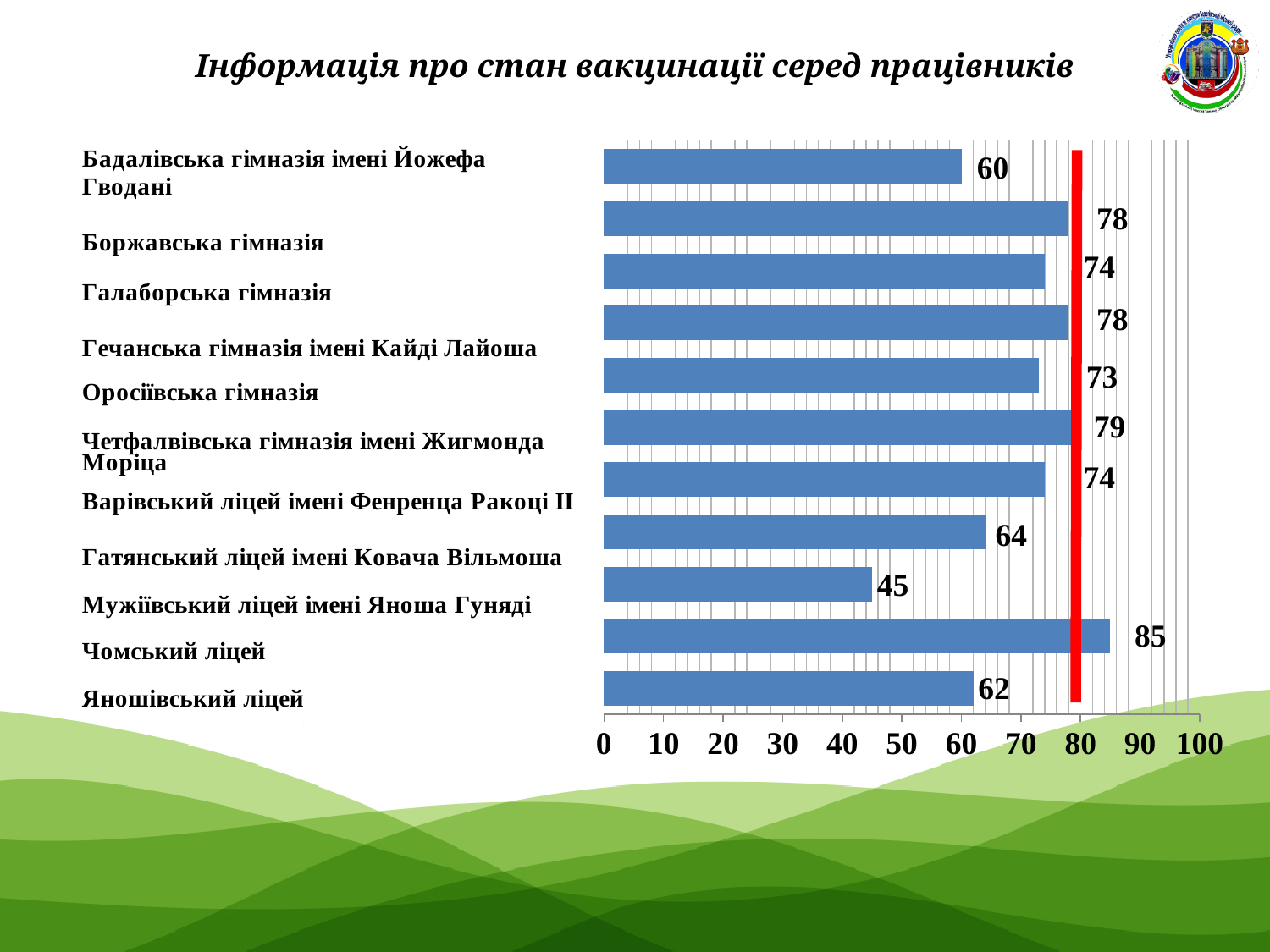
What type of chart is shown on the slide? bar chart What is the value for Оросіївська гімназія? 73 How many categories are shown in the chart? 11 Which category has the lowest value? Мужіївський ліцей імені Яноша Гуняді What is the value for Чомський ліцей? 85 What is the value for Мужіївський ліцей імені Яноша Гуняді? 45 What is the title of the slide? Інформація про стан вакцинації серед працівників What is the value for Яношівський ліцей? 62 Is the value for Бадалівська гімназія імені Йожефа Гводані greater or less than 70? less Which is larger, the value for Боржавська гімназія or the value for Гатянський ліцей імені Ковача Вільмоша? Боржавська гімназія What is the difference between the values for Чомський ліцей and Мужіївський ліцей імені Яноша Гуняді? 40 Which category has the highest value? Чомський ліцей